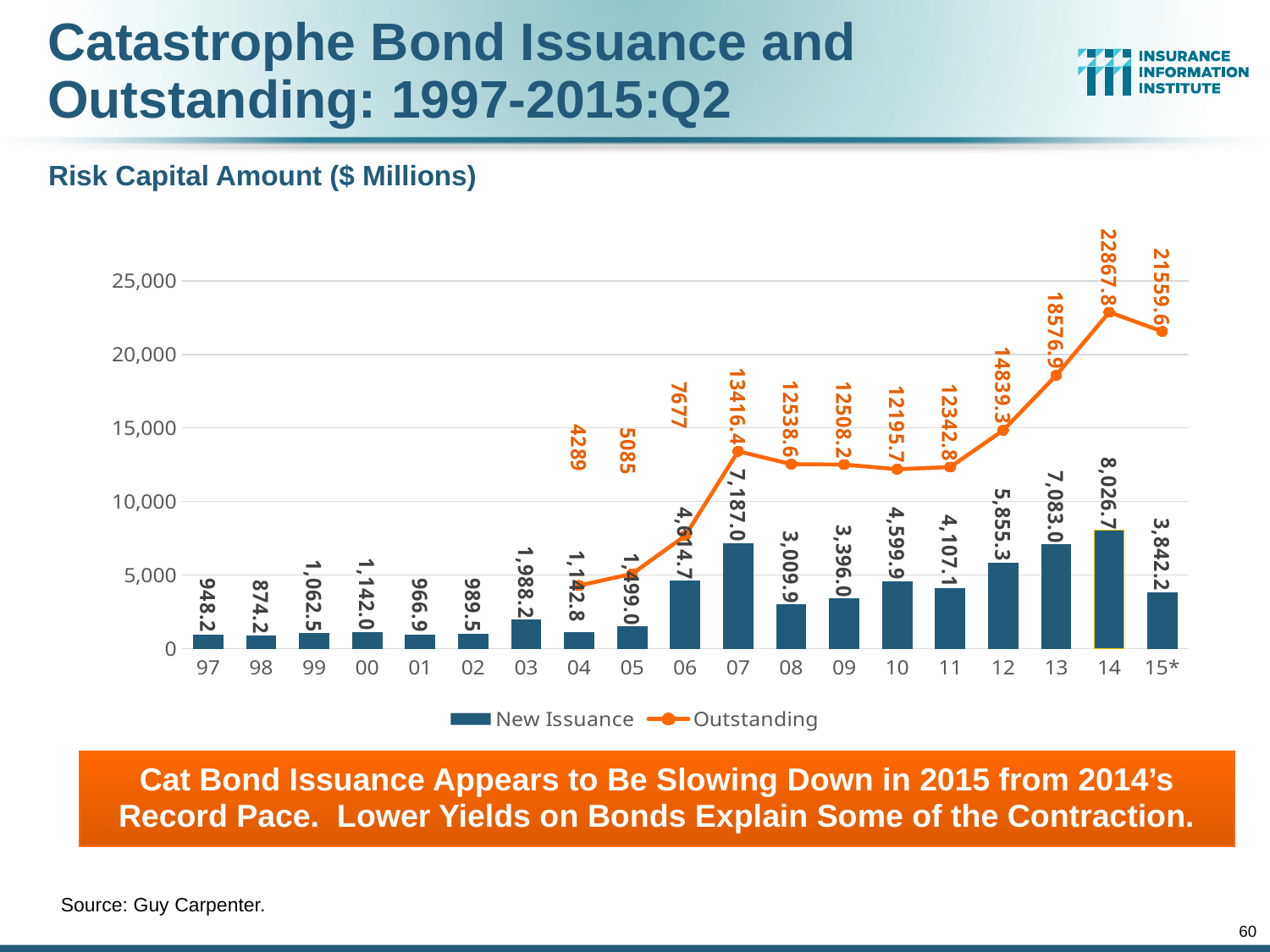
What is the difference between the New Issuance values for 14 and 15*? 4,184.5 Is the Outstanding value for 13 greater or less than 15,000? greater Which year has the larger Outstanding value, 07 or 08? 07 What kind of chart is shown on the slide? Combined bar and line chart What is the Outstanding value for 15*? 21559.6 Which year has the highest New Issuance value? 14 How many series does the legend list? 2 What is the New Issuance value for 14? 8,026.7 What is the Outstanding value for 14? 22867.8 Does the Outstanding line rise or fall from 12 to 14? rise How many years are shown on the x axis? 19 Which year has the lowest New Issuance value? 98